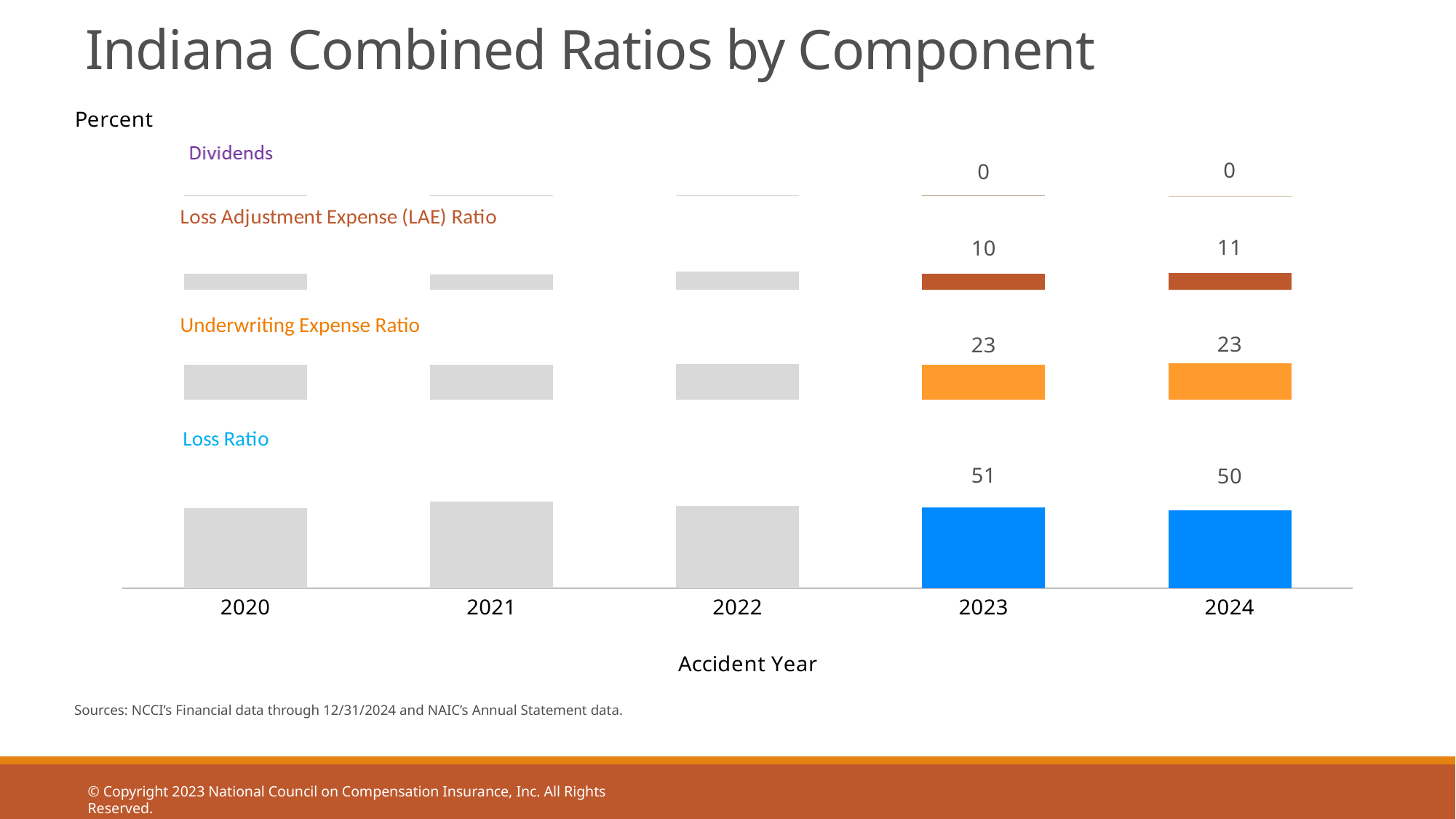
What is the Loss Adjustment Expense (LAE) Ratio for accident year 2023? 10 What is the x-axis title of the chart? Accident Year What is the total of the labeled components (Loss Ratio, Underwriting Expense Ratio, LAE Ratio, Dividends) for accident year 2024? 84 What is the Dividends value for accident year 2023? 0 What is the Loss Ratio for accident year 2024? 50 How many accident years are shown on the x axis? 5 What is the Underwriting Expense Ratio for accident year 2024? 23 Which is larger, the LAE Ratio for 2023 or the LAE Ratio for 2024? 2024 What is the Loss Ratio for accident year 2023? 51 What is the Loss Adjustment Expense (LAE) Ratio for accident year 2024? 11 What kind of chart is shown on the slide? Bar chart What is the difference between the Loss Ratio for 2023 and the Loss Ratio for 2024? 1